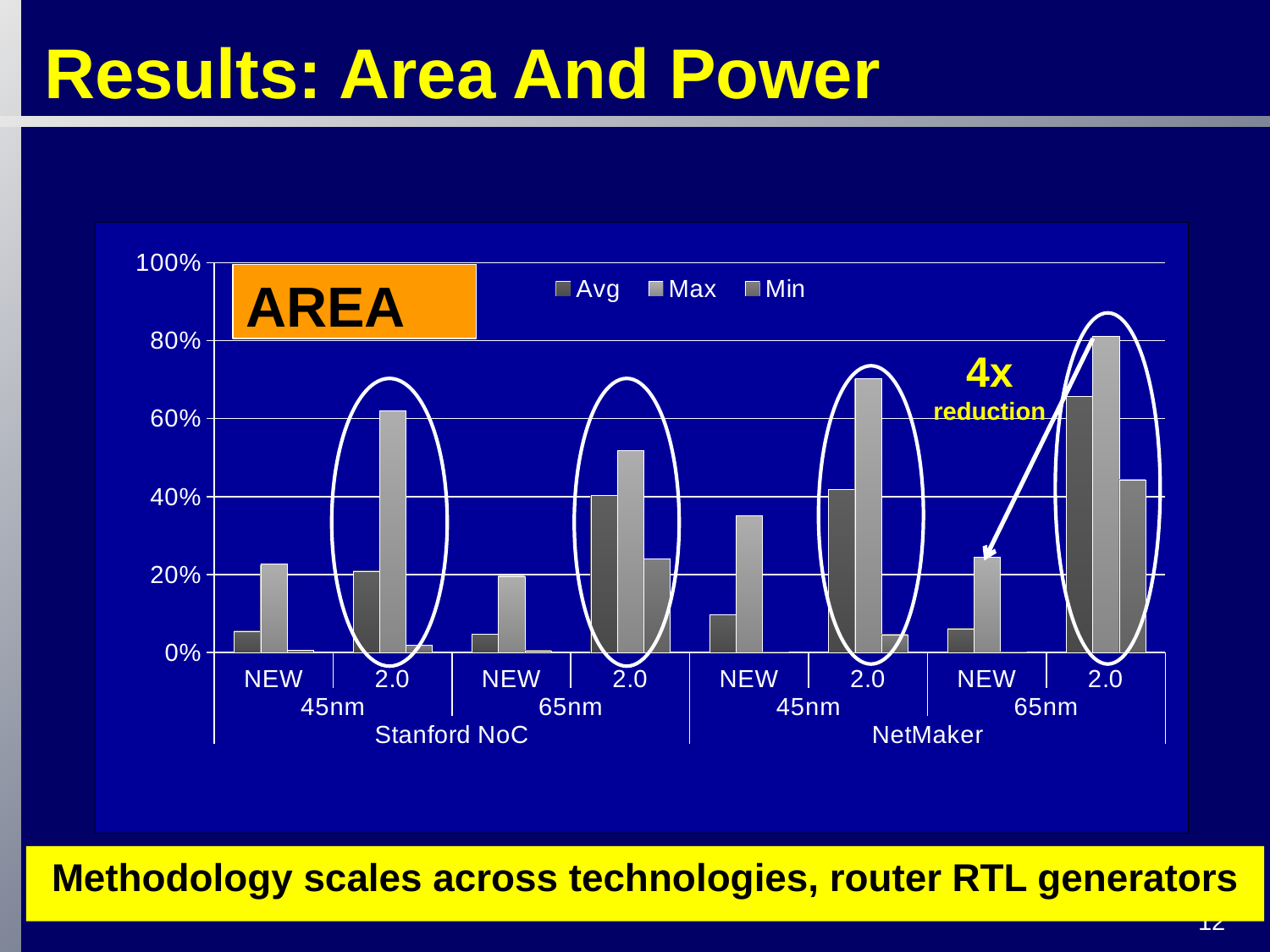
What kind of chart is shown on the slide? bar chart How many series does the legend list? 3 What are the three series named in the legend? Avg, Max, Min Is the Max value for NetMaker 45nm NEW greater or less than 40%? less Is the Max value for Stanford NoC 45nm NEW greater or less than 40%? less Is the Max value for NetMaker 45nm 2.0 greater or less than 60%? greater How many bar groups (NEW/2.0 categories) are plotted along the x axis? 8 Which bar group has the tallest Max bar? NetMaker 65nm 2.0 Within each technology node, is the Max bar for 2.0 higher or lower than the Max bar for NEW? higher What word appears in the orange box inside the chart? AREA Which is larger: the Max bar for NetMaker 65nm 2.0 or the Max bar for Stanford NoC 45nm 2.0? NetMaker 65nm 2.0